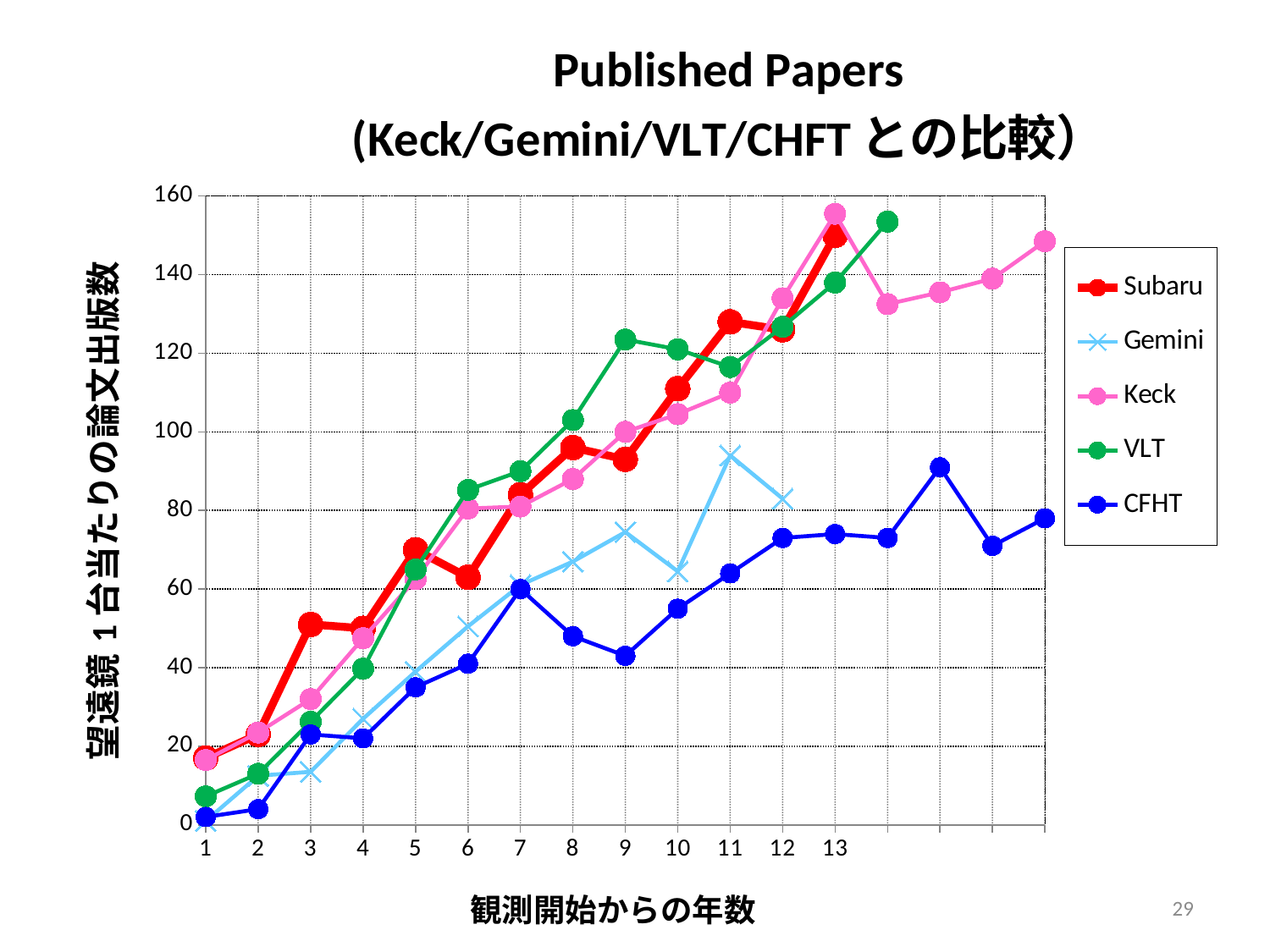
Which series is plotted with a red line? Subaru Is the value for Gemini at year 11 greater or less than 80? greater What is the English part of the chart title? Published Papers At year 9, which is higher, VLT or Subaru? VLT How many series does the legend list? 5 Is the value for Gemini at year 6 greater or less than 60? less Is the value for Subaru at year 13 greater or less than 140? greater At year 11, which is higher, Subaru or Keck? Subaru Which series has the lowest value at year 13? CFHT What kind of chart is shown on the slide? line chart